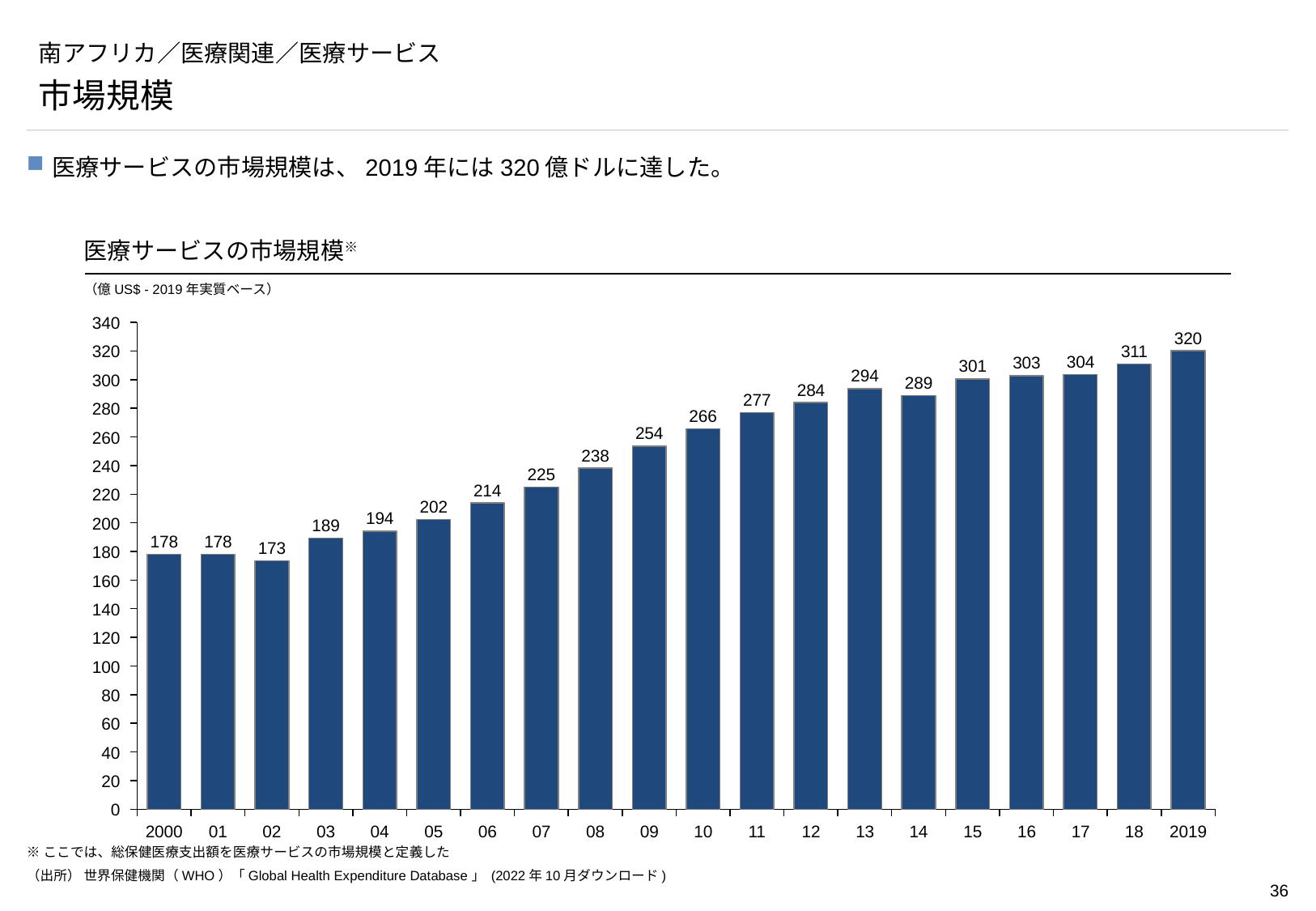
What is the difference between the values for 13 and 14? 5 How many bars are shown in the chart? 20 Do the values generally rise or fall from 2000 to 2019? Rise What is the title of the chart? 医療サービスの市場規模 Which is larger, the value for 13 or the value for 14? 13 Which year has the lowest value? 02 What is the difference between the values for 2019 and 2000? 142 What is the value for 2019? 320 Which year has the highest value? 2019 What is the value for 2010? 266 What kind of chart is this? Bar chart What is the value for 2005? 202